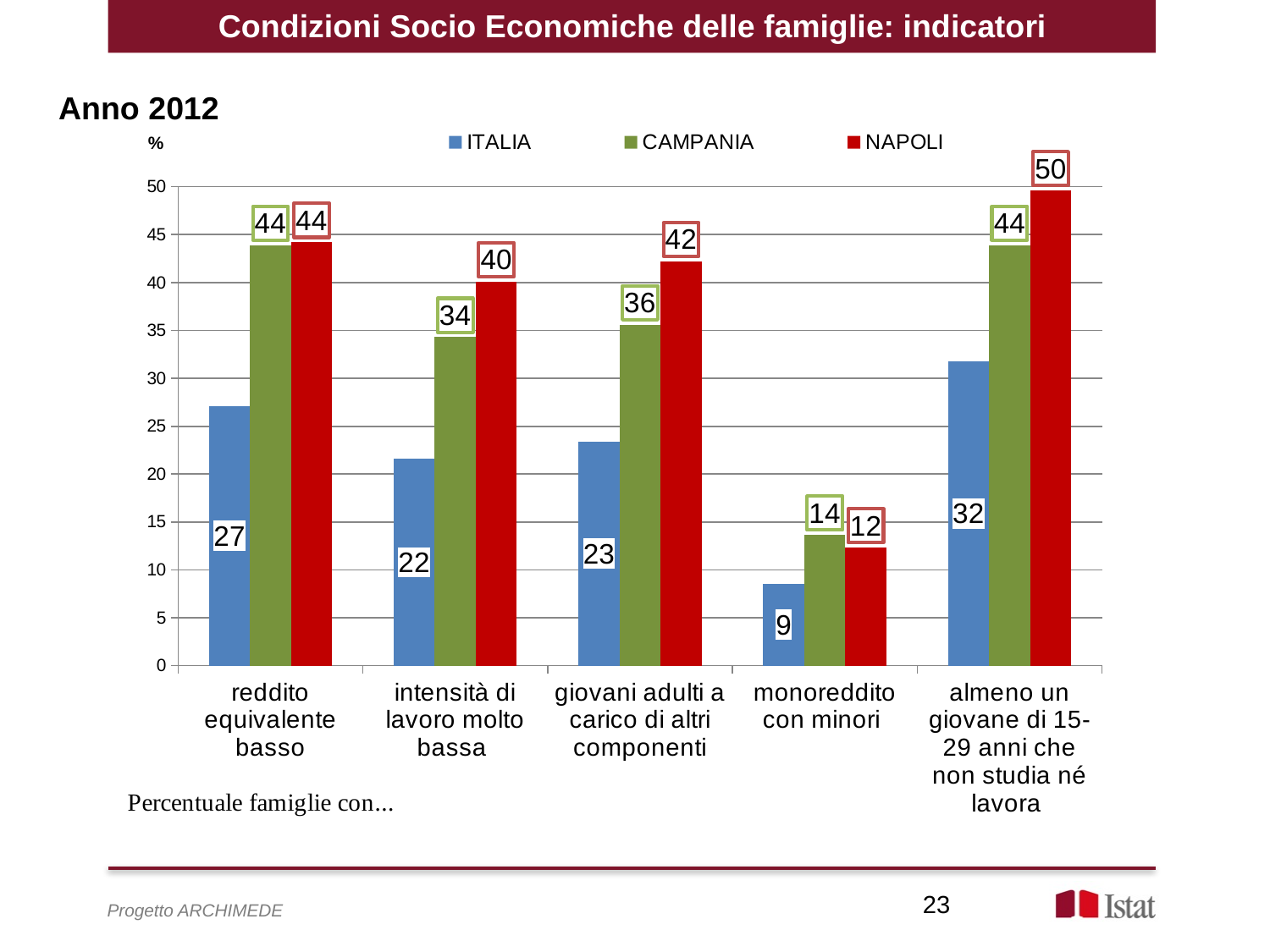
What kind of chart is shown on the slide? bar chart What is the value for ITALIA in the 'monoreddito con minori' category? 9 Which category has the lowest value for CAMPANIA? monoreddito con minori Which series is shown in red in the legend? NAPOLI What is the difference between the NAPOLI and ITALIA values in the 'almeno un giovane di 15-29 anni che non studia né lavora' category? 18 What is the value for NAPOLI in the 'intensità di lavoro molto bassa' category? 40 How many categories are shown on the x axis? 5 In the 'monoreddito con minori' category, which is larger, the CAMPANIA value or the NAPOLI value? CAMPANIA How many series does the legend list? 3 Which category has the highest value for NAPOLI? almeno un giovane di 15-29 anni che non studia né lavora What is the value for ITALIA in the 'reddito equivalente basso' category? 27 What is the value for CAMPANIA in the 'giovani adulti a carico di altri componenti' category? 36